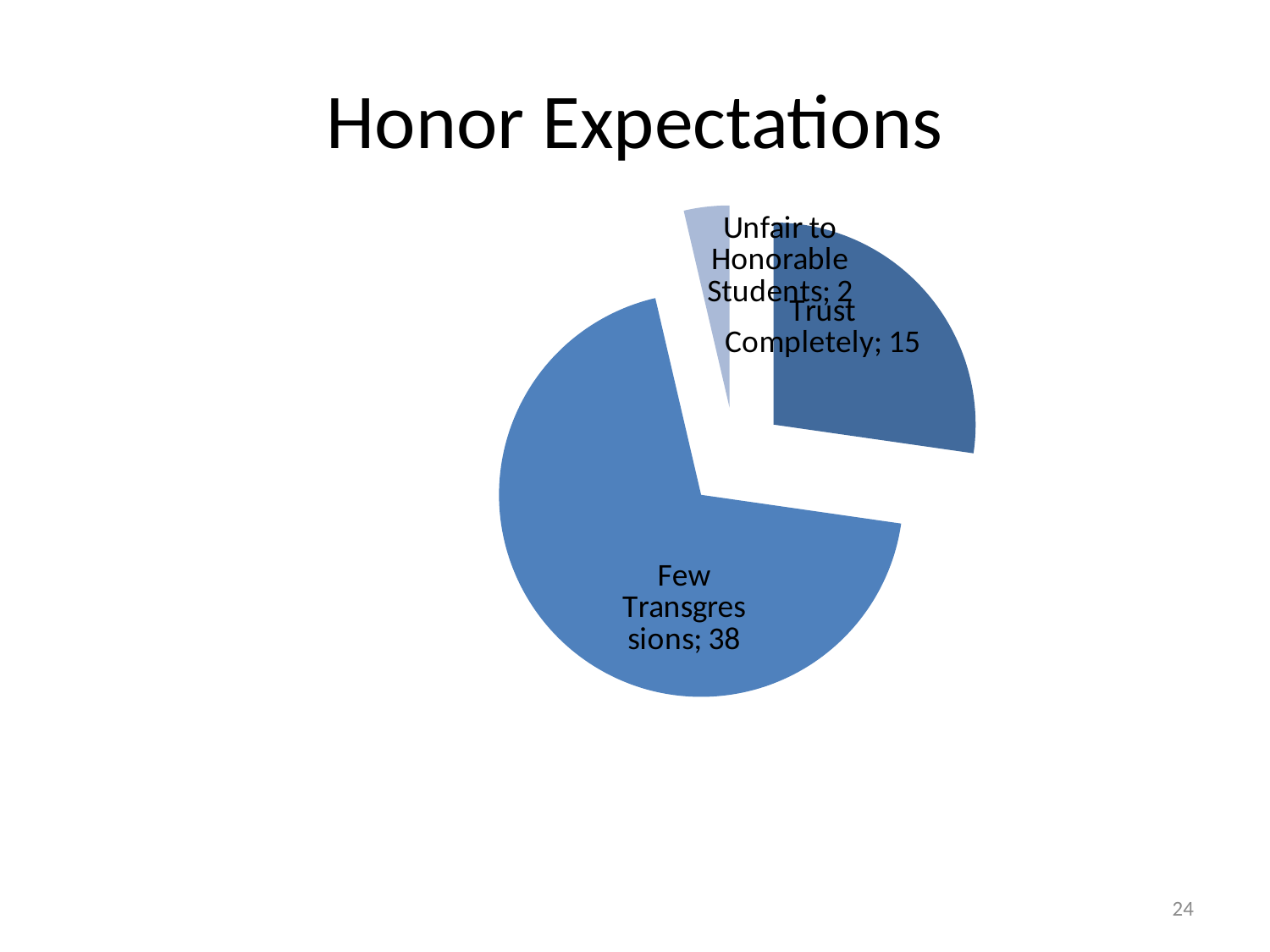
What is the difference between the values for Trust Completely and Unfair to Honorable Students? 13 Which category has the smallest slice of the pie? Unfair to Honorable Students Which is larger, Trust Completely or Unfair to Honorable Students? Trust Completely What is the value for Trust Completely? 15 What is the total of all the slice values in the pie chart? 55 What is the value for Unfair to Honorable Students? 2 What is the difference between the values for Few Transgressions and Trust Completely? 23 What is the title of the slide containing the pie chart? Honor Expectations What is the value for Few Transgressions? 38 What type of chart is shown on the slide? pie chart How many slices does the pie chart have? 3 Which category has the largest slice of the pie? Few Transgressions